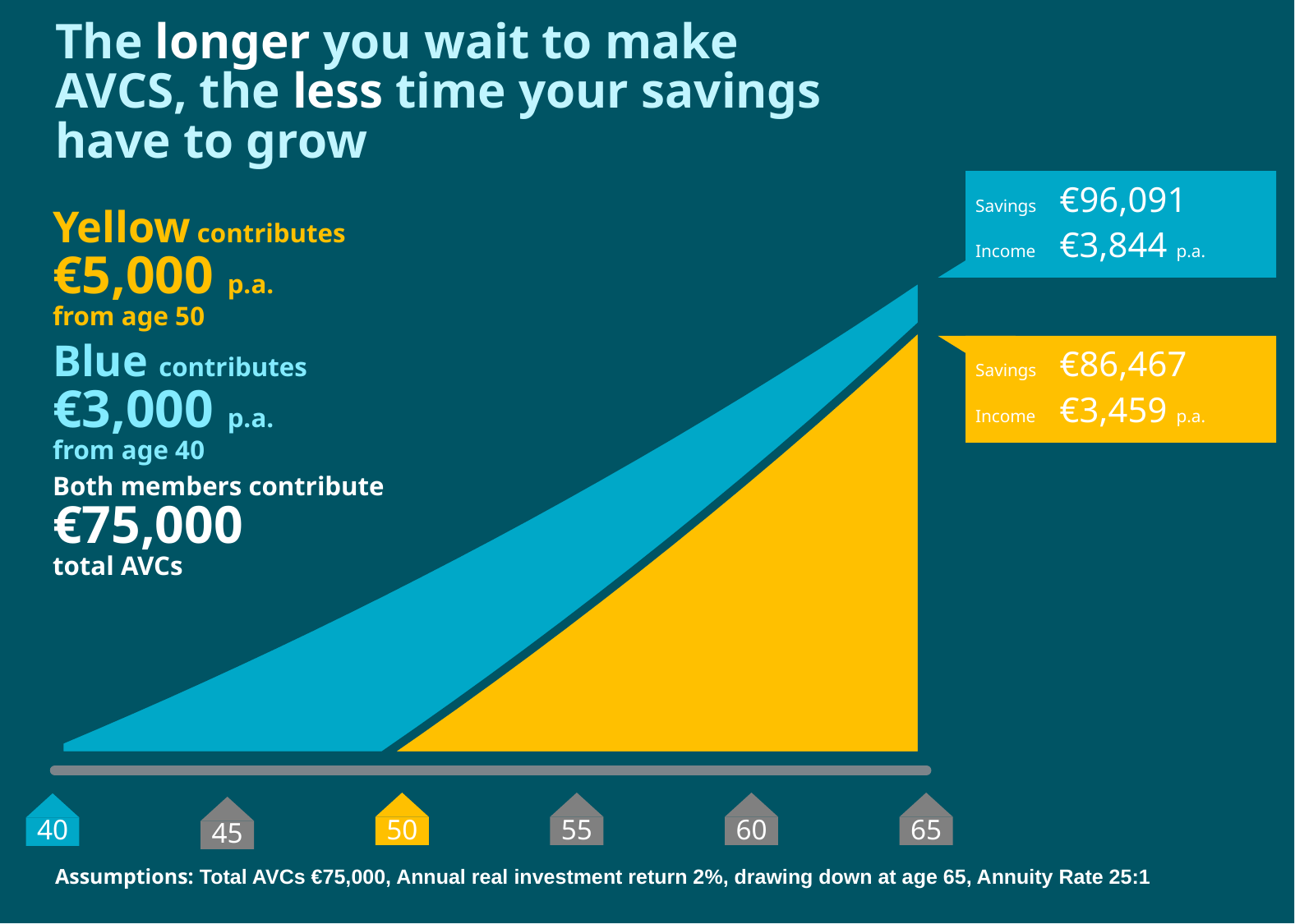
Which member ends up with the higher savings at age 65, Blue or Yellow? Blue How many age markers are shown along the bottom axis? 6 What annual income does the Blue member's savings provide? €3,844 p.a. What is the savings value at age 65 for the Blue member? €96,091 How much does the Yellow member contribute per year, and from what age? €5,000 p.a. from age 50 What annual income does the Yellow member's savings provide? €3,459 p.a. What is the savings value at age 65 for the Yellow member? €86,467 What kind of chart is shown on the slide? Area chart Do the savings areas rise or fall as age increases along the x axis? Rise What is the difference between the Blue member's and the Yellow member's annual income? €385 p.a. What is the difference between the Blue member's and the Yellow member's savings at age 65? €9,624 How much does the Blue member contribute per year, and from what age? €3,000 p.a. from age 40